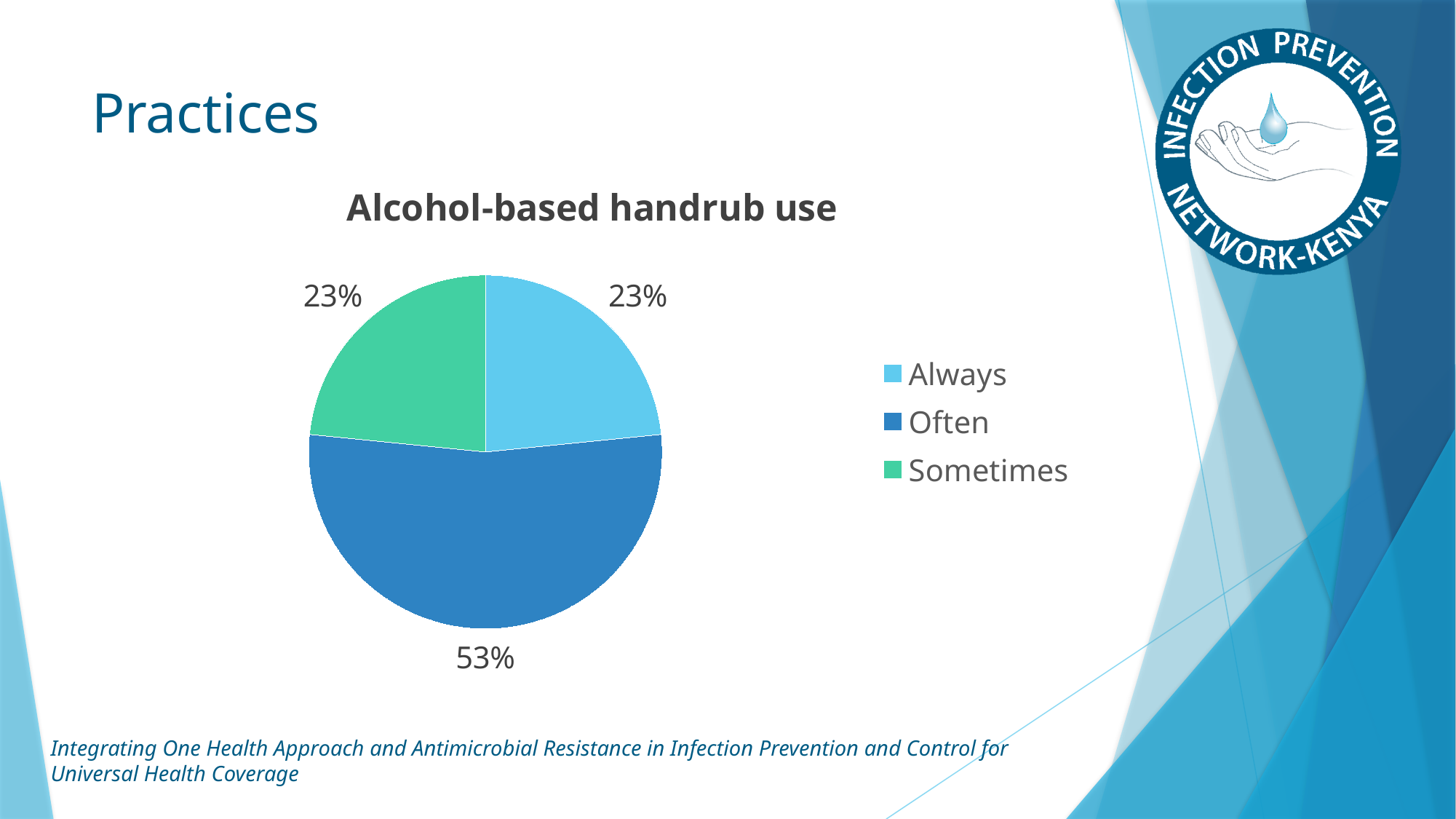
What percentage of the pie is labelled "Always"? 23% What percentage of the pie is labelled "Sometimes"? 23% Which is larger, the share for "Often" or the share for "Sometimes"? Often What is the difference in percentage points between "Often" and "Always"? 30 What percentage of the pie is labelled "Often"? 53% Is the share for "Often" greater or less than 50%? greater Which colour represents "Sometimes" in the chart? green What is the title of the chart? Alcohol-based handrub use Which category has the largest share of the pie? Often What kind of chart is shown on the slide? pie chart How many categories does the legend list? 3 What is the combined share of "Always" and "Sometimes"? 46%